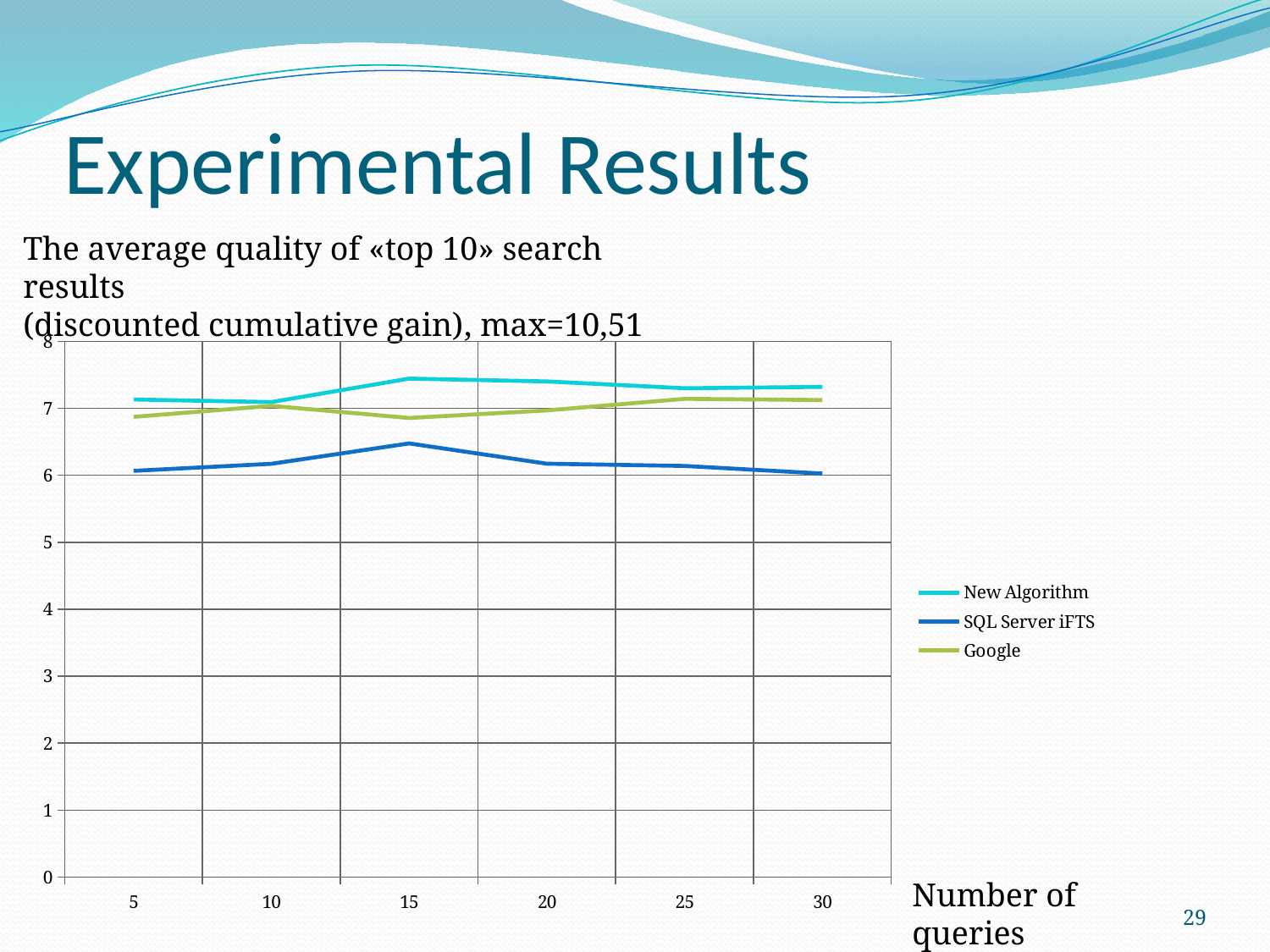
Is the value for Google at 5 queries greater or less than 6? greater How many points along the x axis (number of queries) are plotted for each series? 6 Does the SQL Server iFTS line rise or fall from 15 queries to 30 queries? fall Which series has the highest values across the whole chart? New Algorithm Which series has the lowest values across the whole chart? SQL Server iFTS What kind of chart is shown on the slide? line chart Is the value for SQL Server iFTS at 15 queries greater or less than 7? less At 30 queries, which is larger: Google or SQL Server iFTS? Google What is the label of the x axis? Number of queries Is the value for New Algorithm at 15 queries greater or less than 7? greater How many series does the legend list? 3 At 5 queries, which is larger: New Algorithm or SQL Server iFTS? New Algorithm